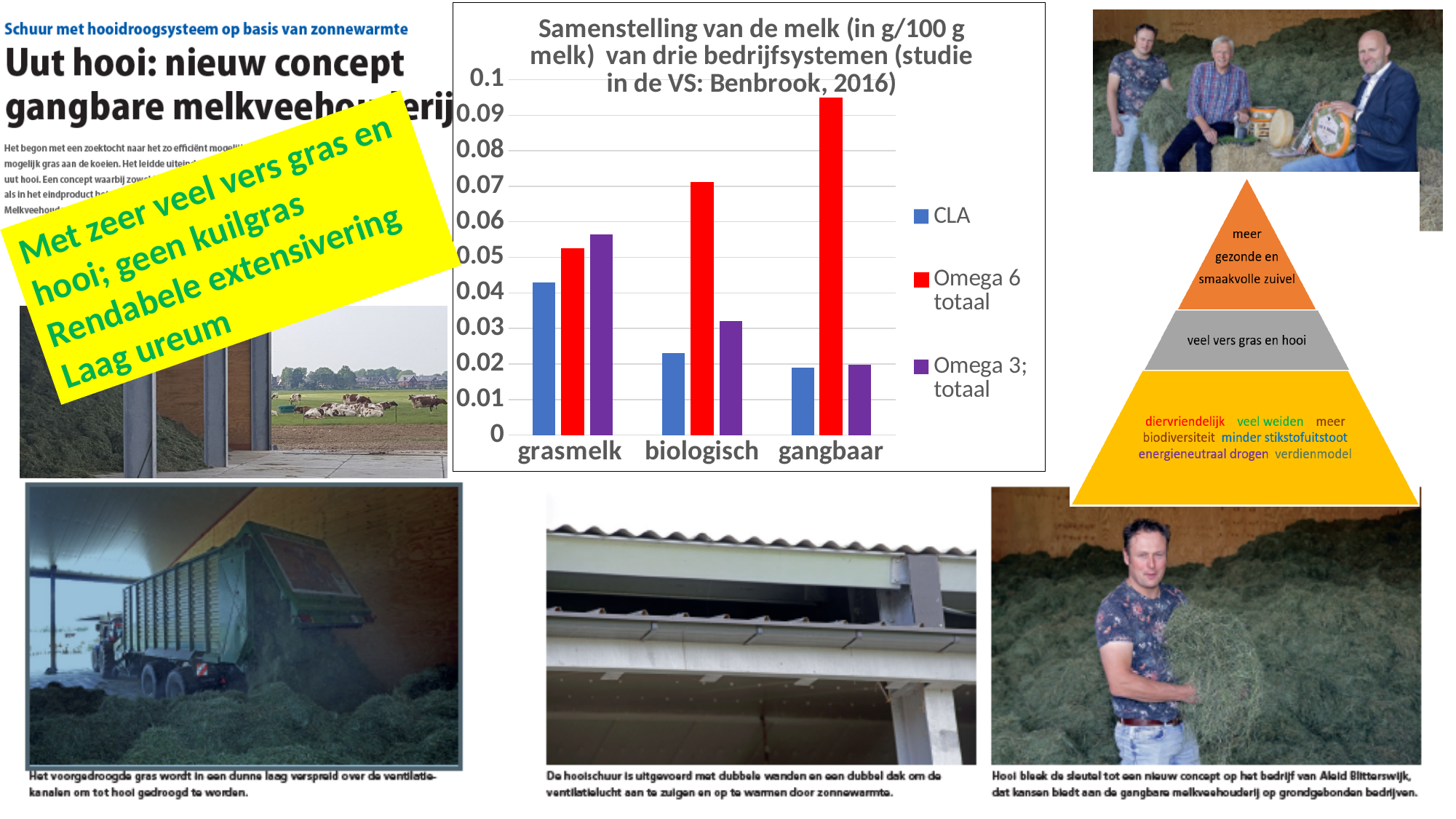
How many series does the chart legend list? 3 Is the Omega 3; totaal value for grasmelk greater or less than 0.05? greater Which category has the highest CLA value? grasmelk How many categories are shown on the x axis of the chart? 3 What kind of chart is shown on the slide? bar chart Which category has the highest Omega 6 totaal value? gangbaar Do the CLA values rise or fall from grasmelk to gangbaar along the x axis? fall What colour are the Omega 6 totaal bars in the chart? red Which category has the lowest Omega 6 totaal value? grasmelk Is the CLA value for biologisch greater or less than 0.03? less Which is larger: the CLA value for grasmelk or the CLA value for gangbaar? grasmelk Is the Omega 6 totaal value for gangbaar greater or less than 0.09? greater